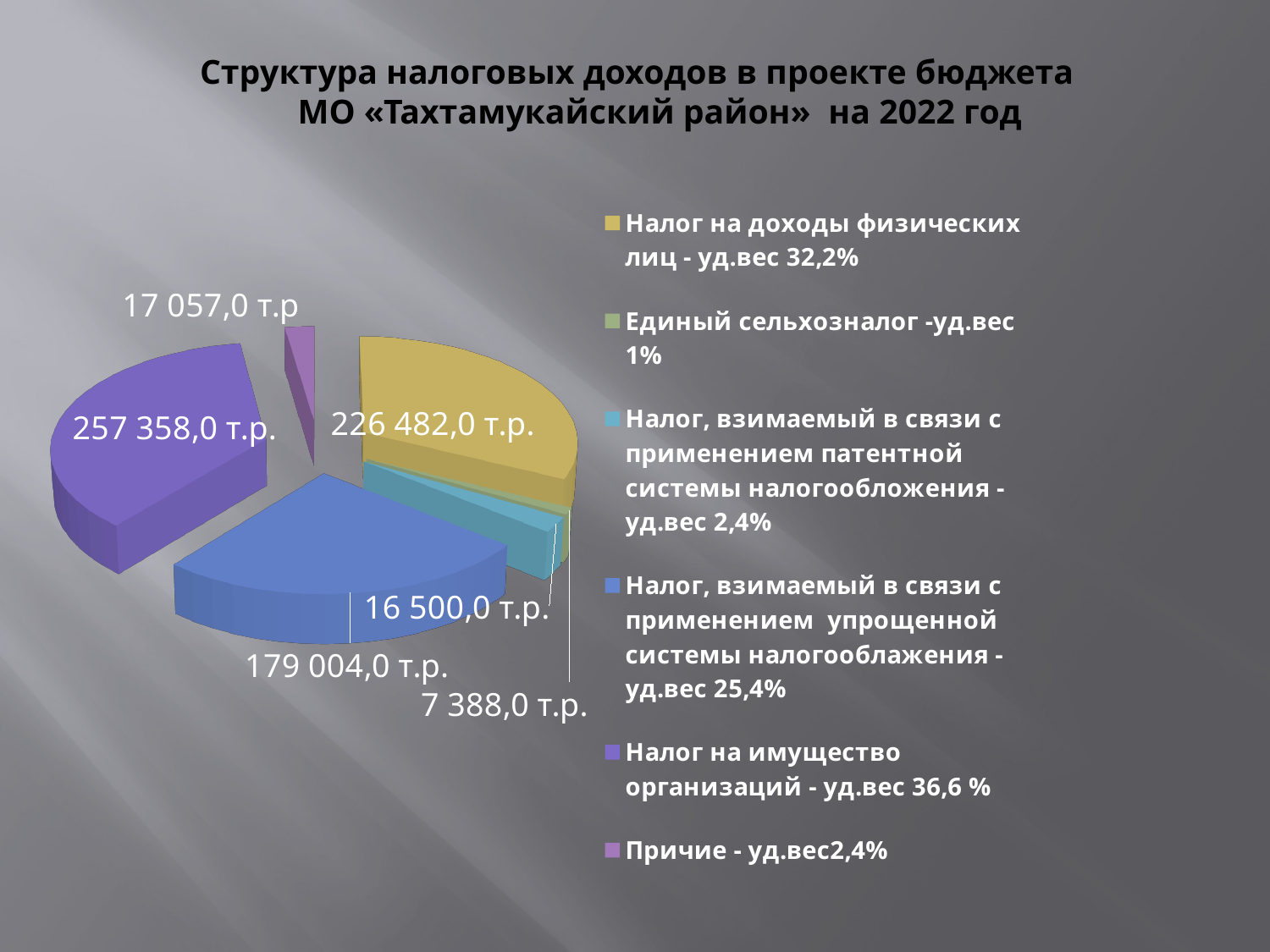
Which category has the smallest slice of the pie? Единый сельхозналог What is the value shown for the tax under the simplified taxation system (упрощенная система налогообложения)? 179 004,0 т.р. Which is larger: the value for Прочие or the value for the patent taxation system tax? Прочие Which category has the largest slice of the pie? Налог на имущество организаций What is the value shown for Налог на доходы физических лиц? 226 482,0 т.р. What share of the pie does the tax under the patent taxation system (патентная система) represent, according to the legend? 2,4% What share of the pie does Налог на доходы физических лиц represent, according to the legend? 32,2% What is the difference between the value for Налог на имущество организаций and the value for Налог на доходы физических лиц? 30 876,0 т.р. What is the value shown for Единый сельхозналог? 7 388,0 т.р. What is the value shown for Налог на имущество организаций? 257 358,0 т.р. How many slices does the pie chart have? 6 What kind of chart is shown on the slide? Pie chart